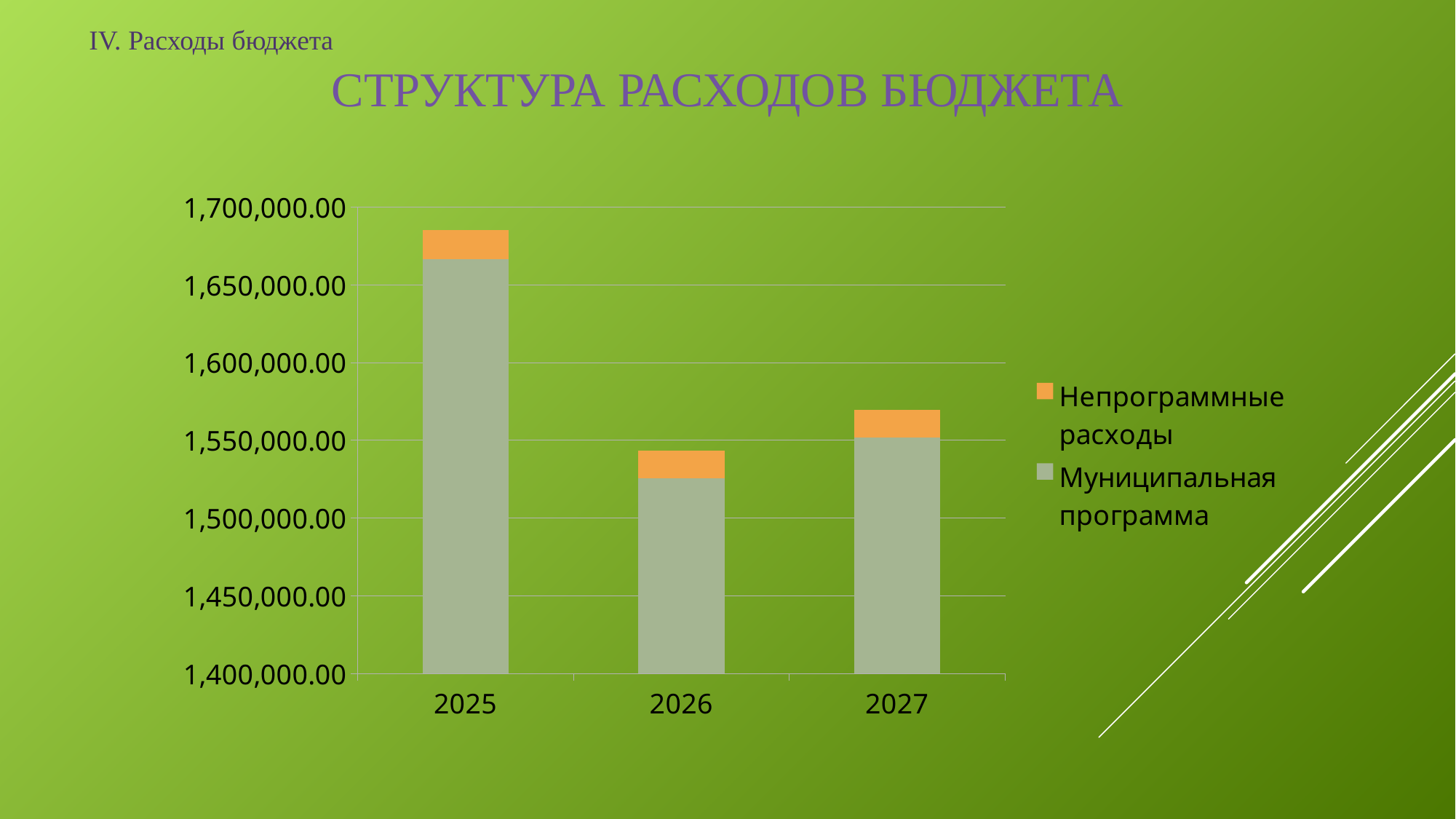
Is the value of Муниципальная программа for 2025 greater or less than 1,650,000.00? greater What kind of chart is shown on the slide? bar chart Is the total stacked bar for 2025 greater or less than 1,650,000.00? greater Which year has the highest total stacked bar? 2025 How many series does the chart legend list? 2 Which year has the larger total bar, 2026 or 2027? 2027 Which series is shown in orange in the chart legend? Непрограммные расходы Which year has the lowest total stacked bar? 2026 Is the total stacked bar for 2027 greater or less than 1,550,000.00? greater Does the total bar height rise or fall from 2025 to 2026? fall How many years are shown on the x axis of the chart? 3